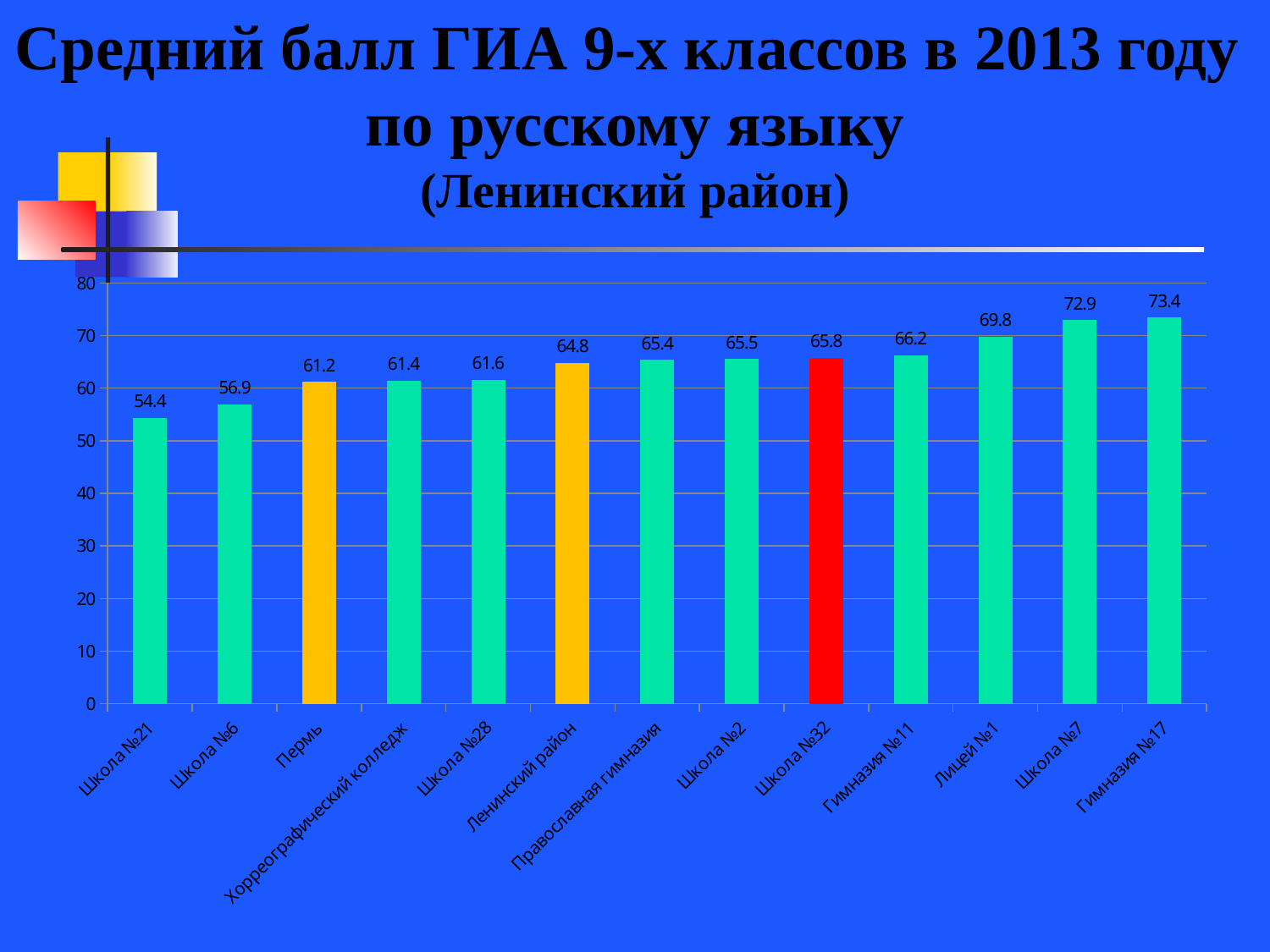
Is the value for Школа №6 greater or less than 60? less What kind of chart is shown on the slide? bar chart What is the difference between the values for Гимназия №17 and Школа №21? 19.0 Which category is shown with a red bar? Школа №32 What is the value for Лицей №1? 69.8 How many categories are shown on the x axis? 13 What is the value for Ленинский район? 64.8 Which is larger, the value for Школа №7 or the value for Пермь? Школа №7 Do the values rise or fall from left to right along the x axis? rise Which category has the highest value? Гимназия №17 Which category has the lowest value? Школа №21 What is the value for Школа №21? 54.4